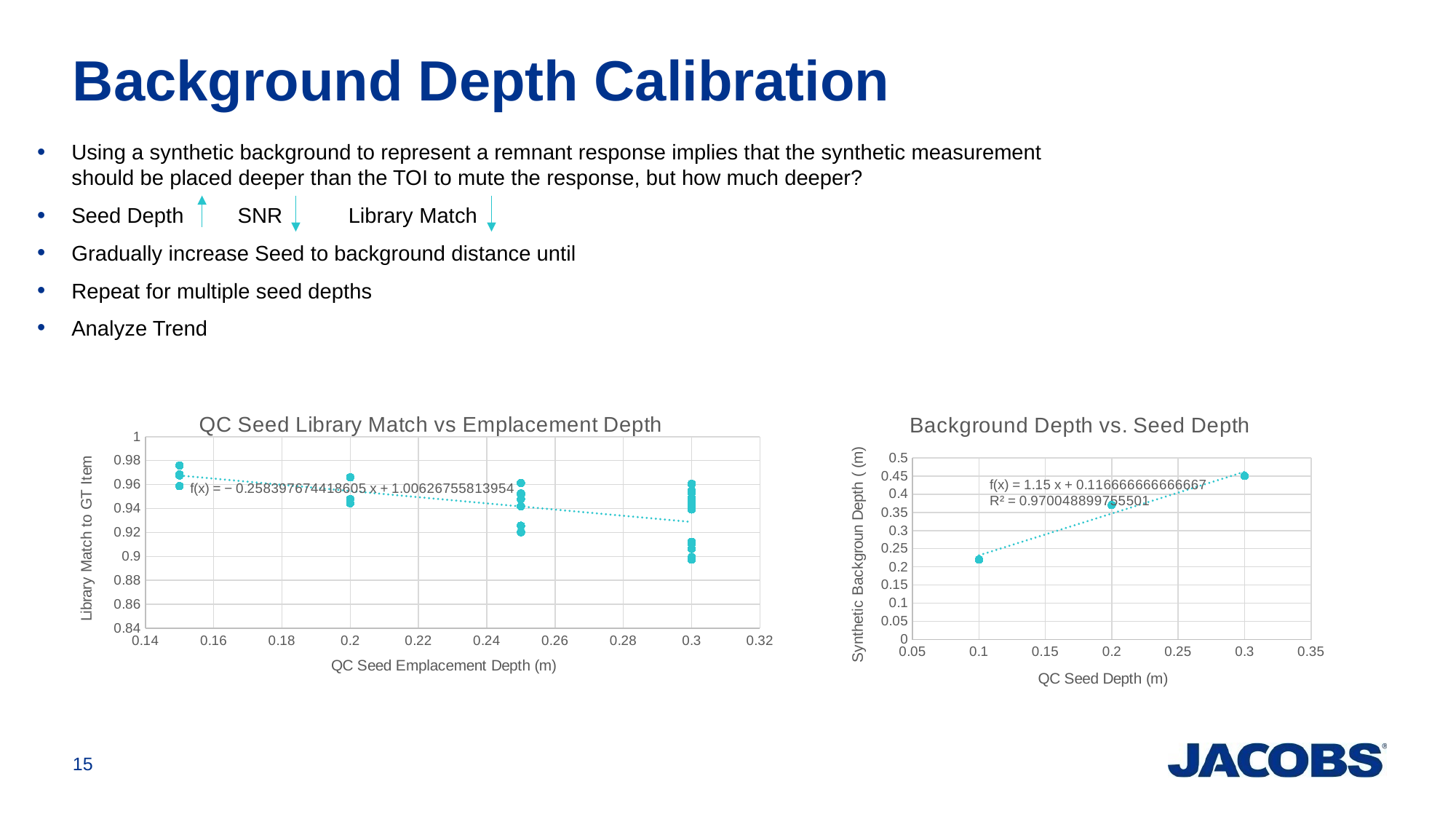
What is the trend line equation shown on the 'Background Depth vs. Seed Depth' chart? f(x) = 1.15 x + 0.116666666666667 In the 'QC Seed Library Match vs Emplacement Depth' chart, does the trend line rise or fall as emplacement depth increases? fall What kind of chart is the 'Background Depth vs. Seed Depth' chart? scatter chart What R² value is shown on the 'Background Depth vs. Seed Depth' chart? 0.970048899755501 In the 'Background Depth vs. Seed Depth' chart, is the synthetic background depth at a QC seed depth of 0.1 greater or less than 0.2? greater In the 'Background Depth vs. Seed Depth' chart, which QC seed depth has the higher synthetic background depth, 0.1 or 0.3? 0.3 In the 'Background Depth vs. Seed Depth' chart, how many data points are plotted? 3 In the 'Background Depth vs. Seed Depth' chart, do the values rise or fall as QC Seed Depth increases? rise In the 'QC Seed Library Match vs Emplacement Depth' chart, are all the library match values at an emplacement depth of 0.15 greater or less than 0.94? greater In the 'QC Seed Library Match vs Emplacement Depth' chart, how many distinct emplacement depths have data points? 4 In the 'Background Depth vs. Seed Depth' chart, is the synthetic background depth at a QC seed depth of 0.2 greater or less than 0.35? greater What kind of chart is the 'QC Seed Library Match vs Emplacement Depth' chart? scatter chart